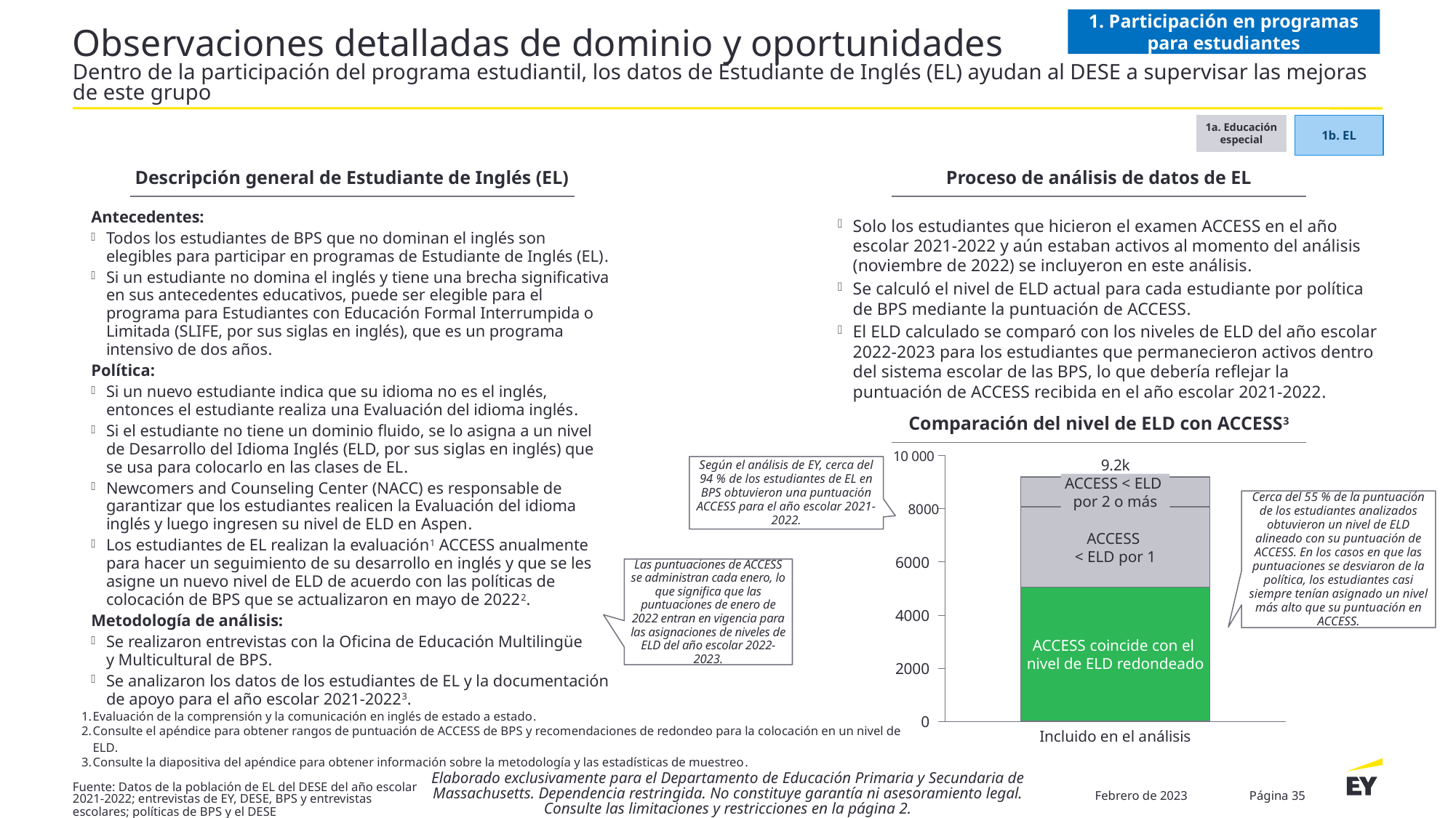
In the "Comparación del nivel de ELD con ACCESS" chart, which segment of the stacked bar is the largest? ACCESS coincide con el nivel de ELD redondeado In the "Comparación del nivel de ELD con ACCESS" chart, is the "ACCESS coincide con el nivel de ELD redondeado" segment greater or less than 4000? greater What colour is the bottom segment of the stacked bar in the "Comparación del nivel de ELD con ACCESS" chart? Green What is the total value printed above the stacked bar in the "Comparación del nivel de ELD con ACCESS" chart? 9.2k What kind of chart is shown under the title "Comparación del nivel de ELD con ACCESS"? Stacked bar chart How many categories are plotted on the x axis of the "Comparación del nivel de ELD con ACCESS" chart? 1 In the "Comparación del nivel de ELD con ACCESS" chart, which segment of the stacked bar is the smallest? ACCESS < ELD por 2 o más What is the x-axis category label of the bar in the "Comparación del nivel de ELD con ACCESS" chart? Incluido en el análisis In the "Comparación del nivel de ELD con ACCESS" chart, which is larger: the "ACCESS coincide con el nivel de ELD redondeado" segment or the "ACCESS < ELD por 1" segment? ACCESS coincide con el nivel de ELD redondeado In the "Comparación del nivel de ELD con ACCESS" chart, is the total height of the stacked bar greater or less than 8000? greater In the "Comparación del nivel de ELD con ACCESS" chart, is the "ACCESS coincide con el nivel de ELD redondeado" segment greater or less than 6000? less How many segments make up the stacked bar in the "Comparación del nivel de ELD con ACCESS" chart? 3